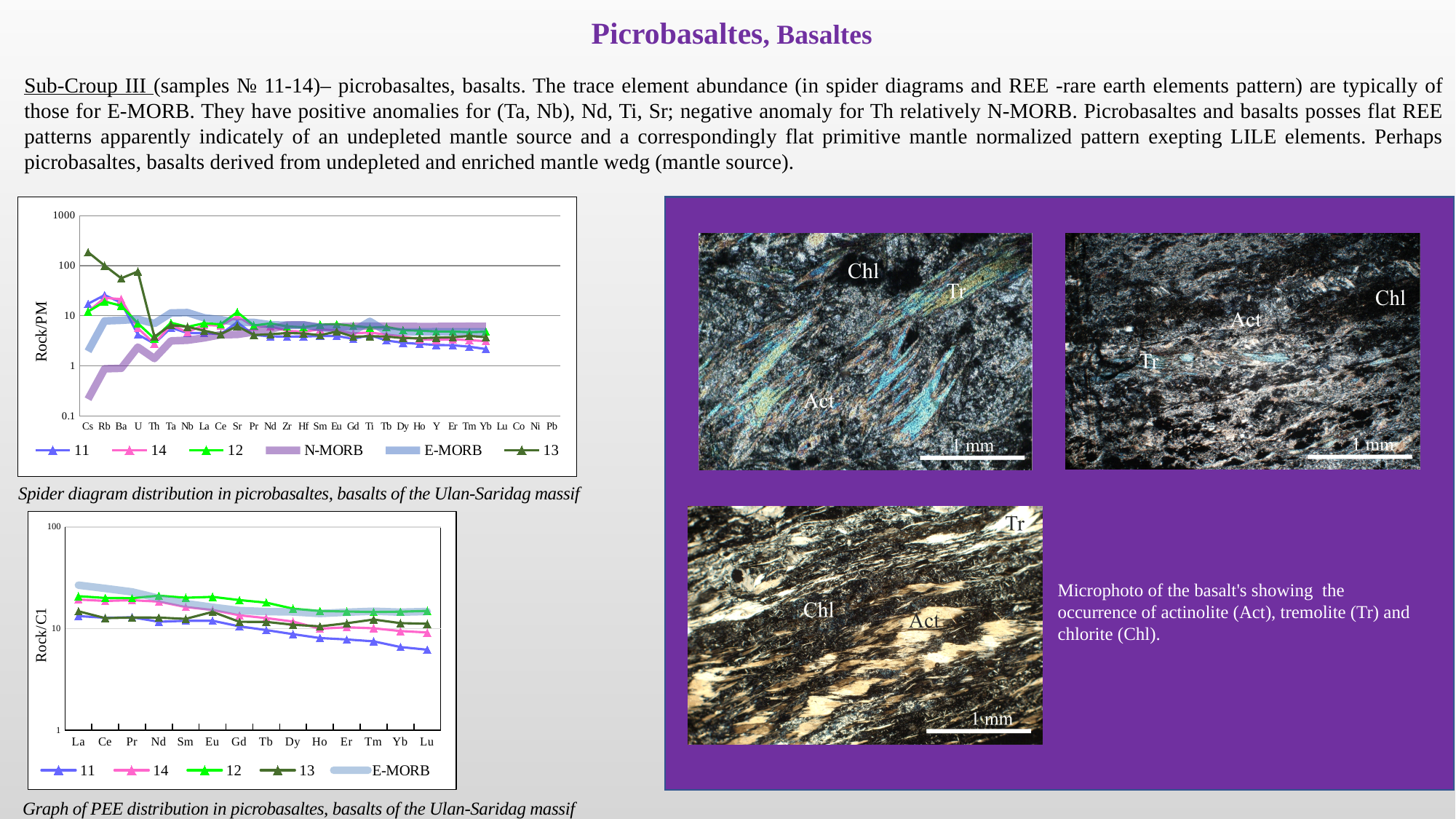
In the spider diagram (top-left chart), is the value of series 13 at Cs greater or less than 100? greater In the PEE distribution graph (bottom-left chart), is the value of E-MORB at La greater or less than 10? greater What type of chart is the spider diagram (top-left chart)? line chart In the PEE distribution graph (bottom-left chart), which series has the lowest value at Lu? 11 How many elements are shown on the x axis of the PEE distribution graph (bottom-left chart)? 14 What is the y-axis label of the PEE distribution graph (bottom-left chart)? Rock/C1 In the spider diagram (top-left chart), is the value of N-MORB at Cs greater or less than 1? less How many series does the legend of the spider diagram (top-left chart) list? 6 In the spider diagram (top-left chart), which series has the highest value at Cs? 13 How many series does the legend of the PEE distribution graph (bottom-left chart) list? 5 In the PEE distribution graph (bottom-left chart), does series 11 rise or fall from La to Lu? fall